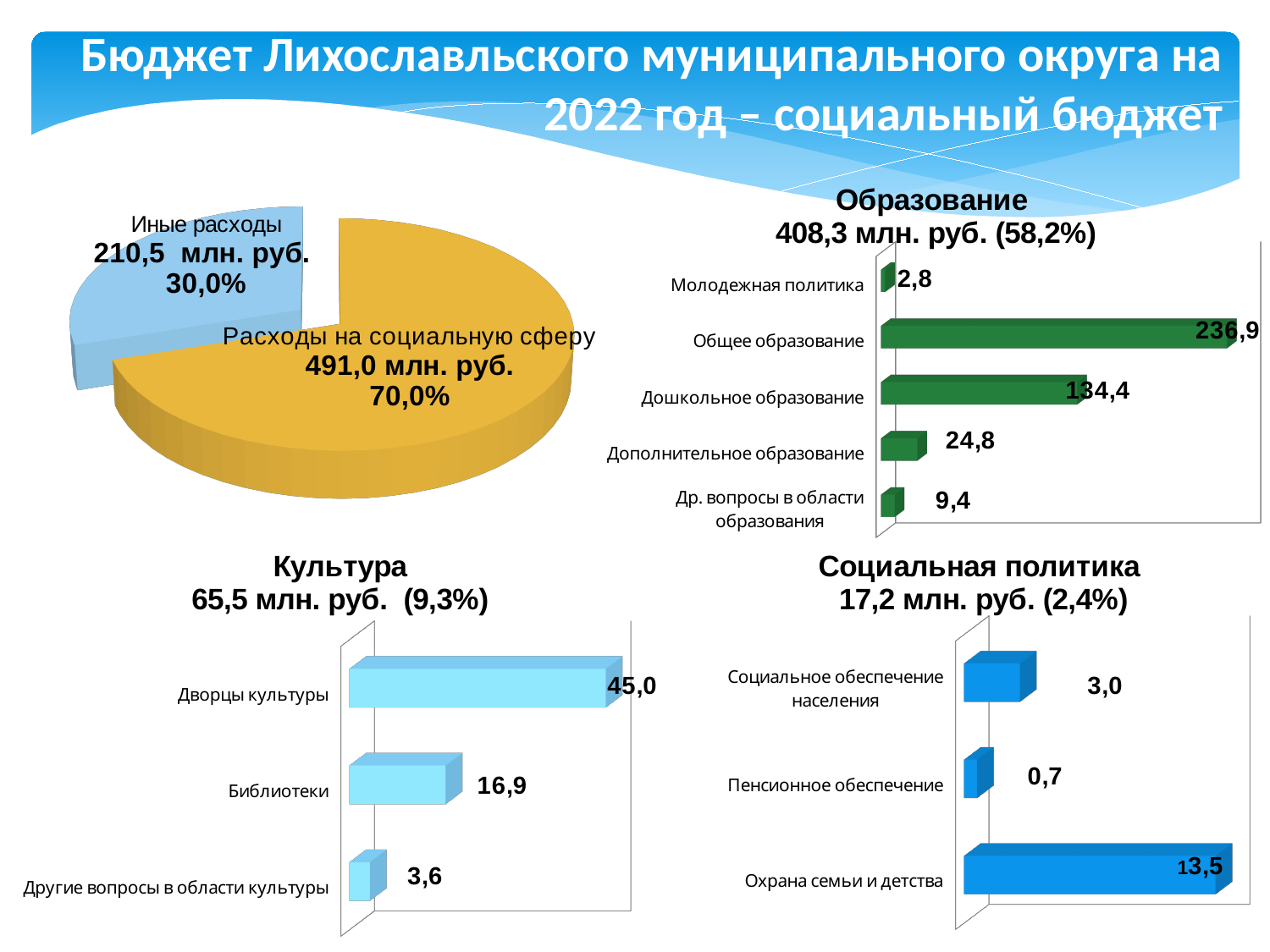
In the Социальная политика chart, which is larger: Социальное обеспечение населения or Охрана семьи и детства? Охрана семьи и детства In the Социальная политика chart, what is the value for Пенсионное обеспечение? 0,7 In the Образование chart, which category has the lowest value? Молодежная политика What kind of chart is the Культура chart? bar chart What total amount is shown in the title of the Социальная политика chart? 17,2 млн. руб. (2,4%) In the pie chart at the top left, what value is shown for Расходы на социальную сферу? 491,0 млн. руб. In the Культура chart, which category has the highest value? Дворцы культуры In the Образование chart, what is the difference between Общее образование and Дошкольное образование? 102,5 In the Образование chart, how many categories are plotted? 5 In the Образование chart, what is the value for Общее образование? 236,9 In the Культура chart, what is the value for Библиотеки? 16,9 In the pie chart at the top left, what share of the pie does Иные расходы take? 30,0%